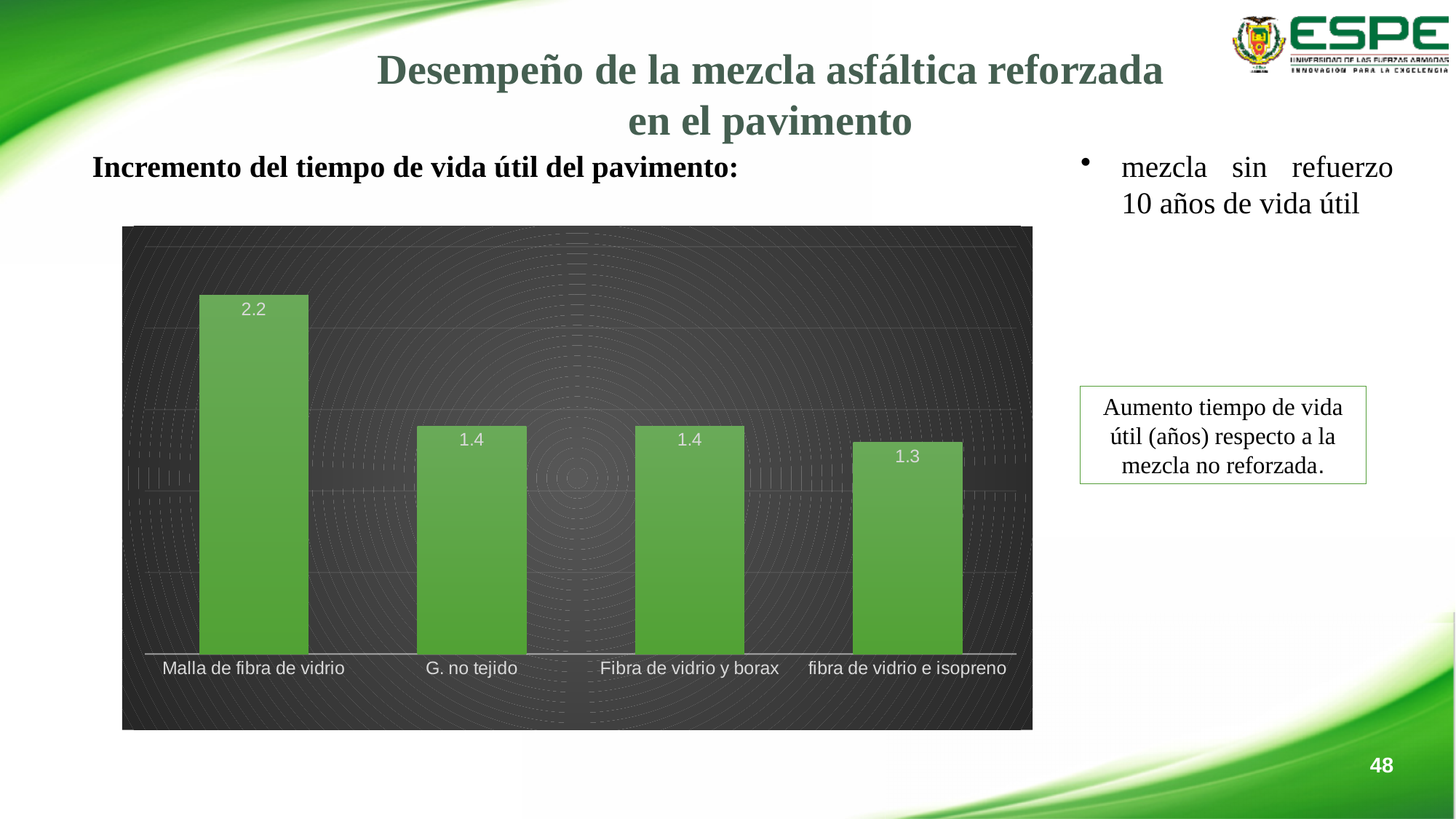
What is the value for Fibra de vidrio y borax? 1.4 Which category has the lowest value? fibra de vidrio e isopreno What is the difference between the values for Fibra de vidrio y borax and fibra de vidrio e isopreno? 0.1 What colour are the bars in the chart? Green Which category has the highest value? Malla de fibra de vidrio What is the value for fibra de vidrio e isopreno? 1.3 What is the value for G. no tejido? 1.4 Which is larger, the value for Malla de fibra de vidrio or the value for fibra de vidrio e isopreno? Malla de fibra de vidrio What is the value for Malla de fibra de vidrio? 2.2 What is the difference between the values for Malla de fibra de vidrio and G. no tejido? 0.8 How many categories are shown in the chart? 4 What kind of chart is shown on the slide? Bar chart